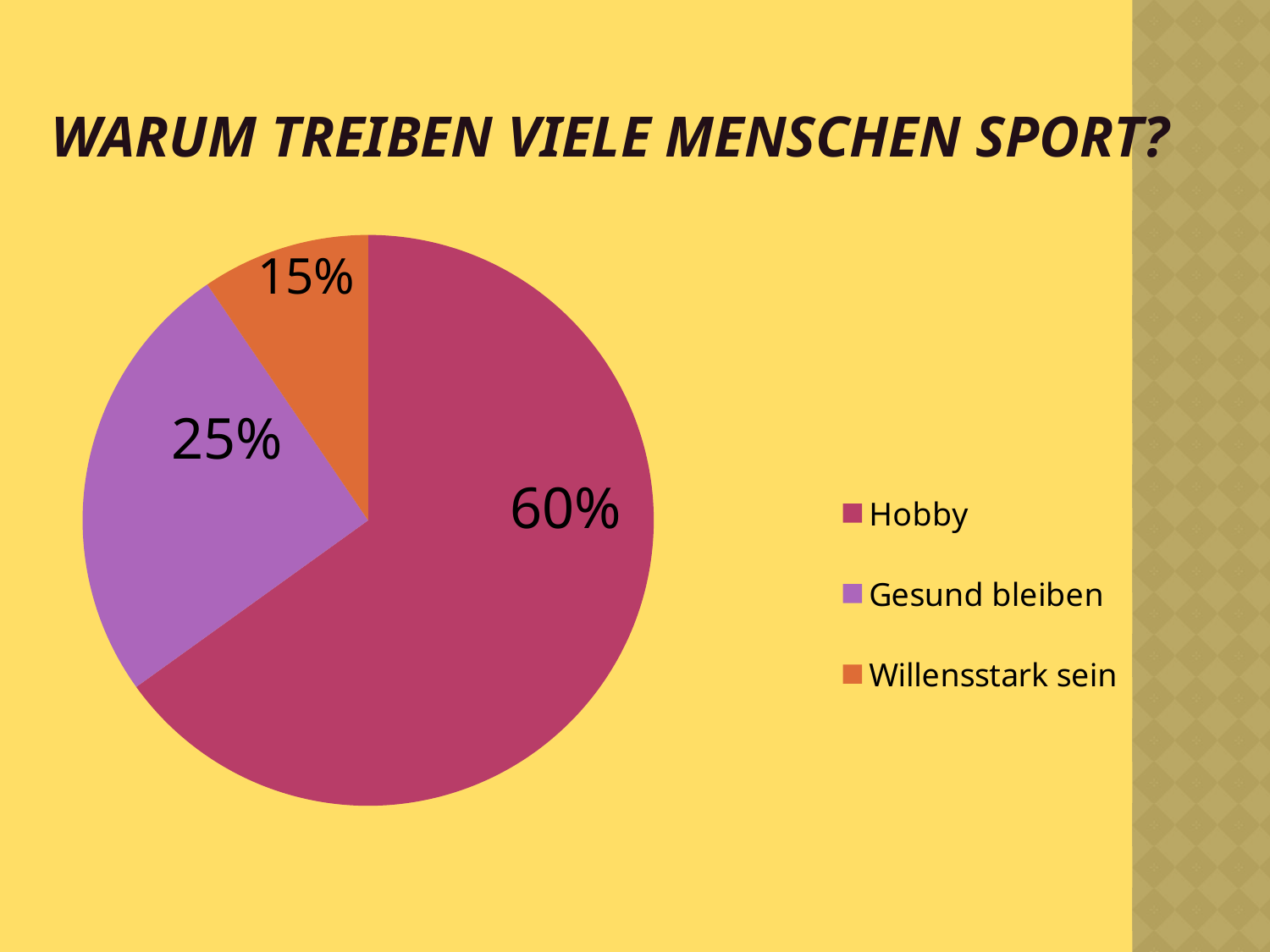
Which is larger, the value for Gesund bleiben or the value for Willensstark sein? Gesund bleiben What kind of chart is shown on the slide? pie chart What is the value for Hobby? 60% What is the difference between the values for Hobby and Gesund bleiben? 35% What is the title of the slide? WARUM TREIBEN VIELE MENSCHEN SPORT? What is the value for Gesund bleiben? 25% Which category has the largest slice? Hobby What is the difference between the values for Gesund bleiben and Willensstark sein? 10% Which category has the smallest slice? Willensstark sein Which colour represents Willensstark sein in the legend? orange How many categories does the pie chart have? 3 What is the value for Willensstark sein? 15%